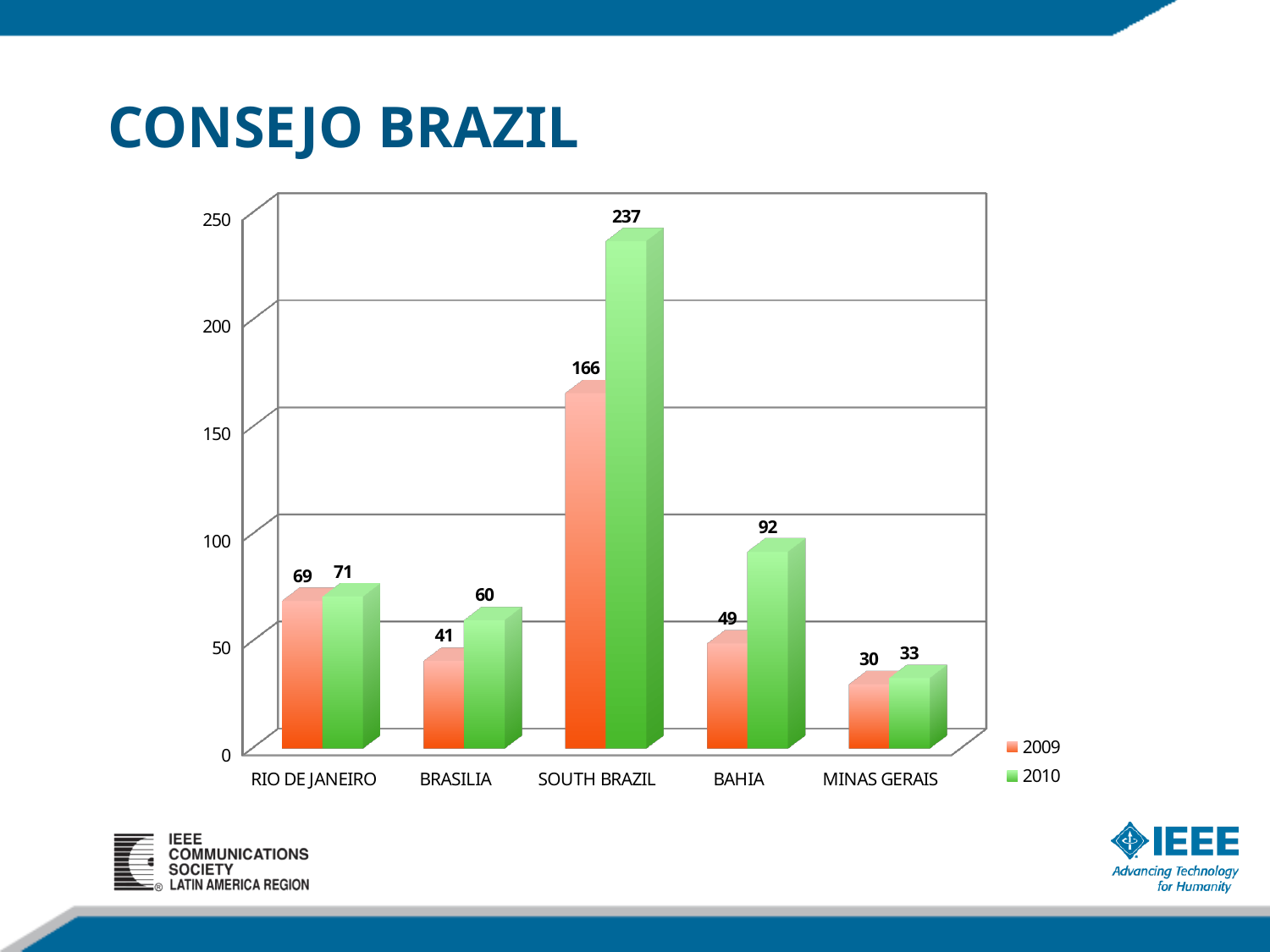
How many categories are shown on the x axis? 5 Which category has the highest 2010 value? SOUTH BRAZIL What is the 2009 value for BRASILIA? 41 What is the 2010 value for SOUTH BRAZIL? 237 What is the difference between the 2010 and 2009 values for SOUTH BRAZIL? 71 Which series is shown in green in the legend? 2010 What is the difference between the 2010 values for BAHIA and BRASILIA? 32 How many series does the legend list? 2 What is the 2009 value for BAHIA? 49 What kind of chart is shown on the slide? Bar chart Which is larger, the 2010 value for RIO DE JANEIRO or the 2010 value for BAHIA? BAHIA Which category has the lowest 2009 value? MINAS GERAIS